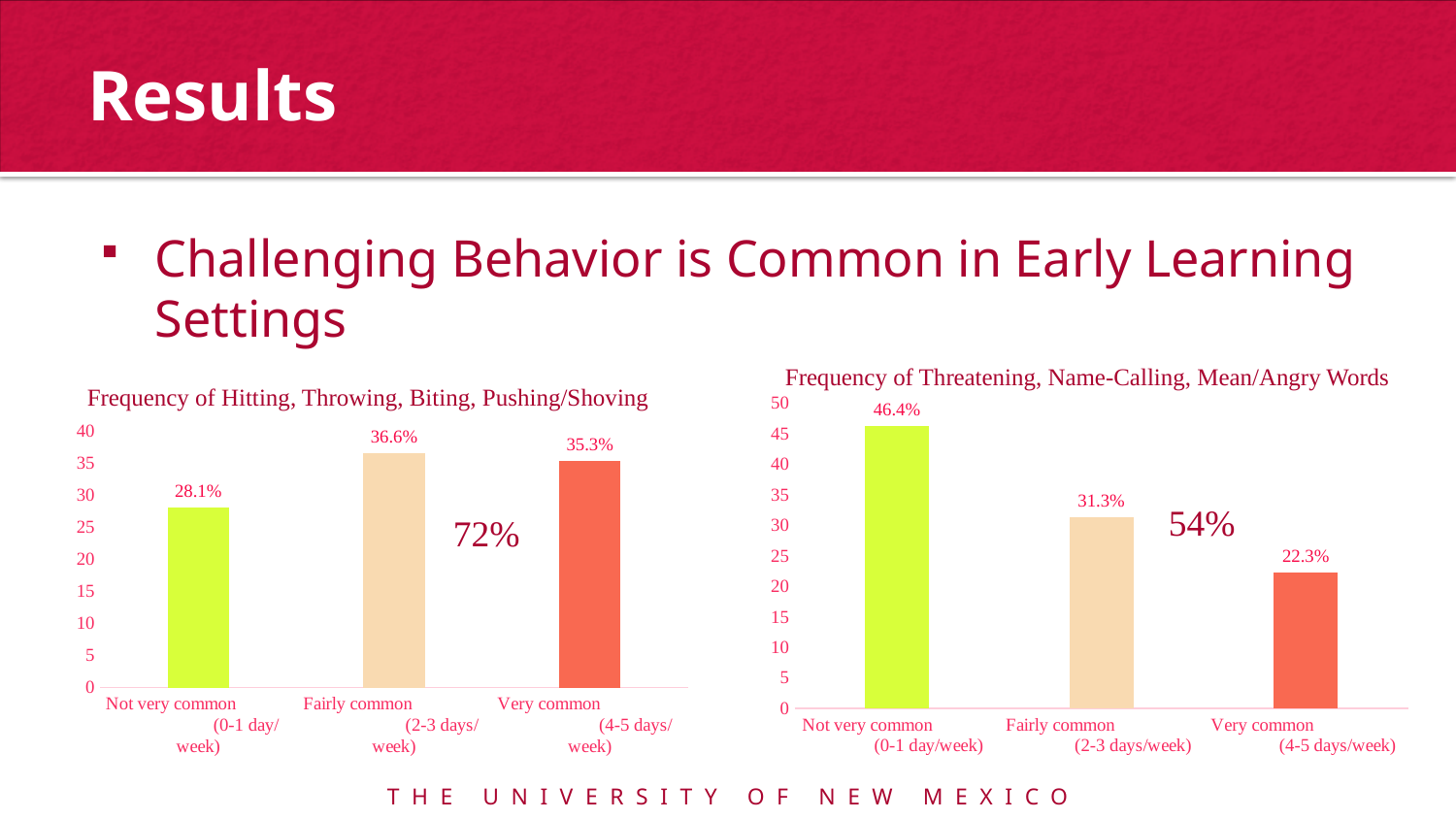
In the chart titled "Frequency of Hitting, Throwing, Biting, Pushing/Shoving", what is the difference between the values for Fairly common and Very common? 1.3% In the chart titled "Frequency of Threatening, Name-Calling, Mean/Angry Words", do the values rise or fall from Not very common to Very common? Fall What kind of chart is the chart titled "Frequency of Threatening, Name-Calling, Mean/Angry Words"? Bar chart In the chart titled "Frequency of Hitting, Throwing, Biting, Pushing/Shoving", what is the value for Not very common? 28.1% In the chart titled "Frequency of Threatening, Name-Calling, Mean/Angry Words", what is the difference between the values for Not very common and Very common? 24.1% What large percentage is printed inside the plot area of the chart titled "Frequency of Hitting, Throwing, Biting, Pushing/Shoving"? 72% In the chart titled "Frequency of Hitting, Throwing, Biting, Pushing/Shoving", which category has the lowest value? Not very common In the chart titled "Frequency of Threatening, Name-Calling, Mean/Angry Words", which category has the highest value? Not very common In the chart titled "Frequency of Threatening, Name-Calling, Mean/Angry Words", which is larger, the value for Fairly common or the value for Very common? Fairly common In the chart titled "Frequency of Hitting, Throwing, Biting, Pushing/Shoving", what is the value for Fairly common? 36.6% How many categories are shown in the chart titled "Frequency of Hitting, Throwing, Biting, Pushing/Shoving"? 3 In the chart titled "Frequency of Threatening, Name-Calling, Mean/Angry Words", what is the value for Very common? 22.3%